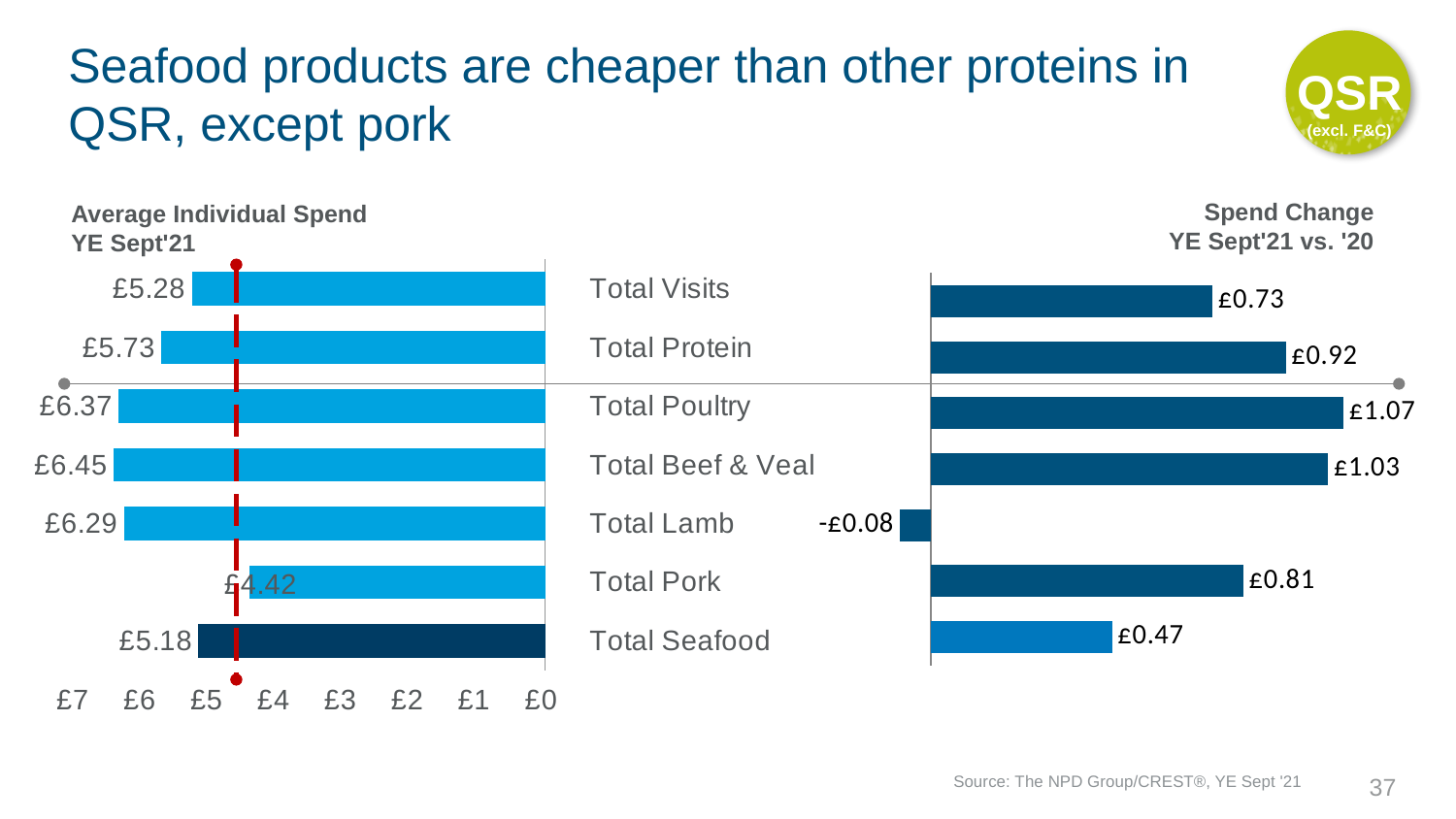
In the Spend Change chart, what is the value for Total Lamb? -£0.08 In the Spend Change chart, what is the value for Total Poultry? £1.07 How many categories are shown in the Average Individual Spend chart? 7 What kind of chart is the Spend Change chart? Bar chart In the Average Individual Spend chart, what is the difference between Total Beef & Veal and Total Seafood? £1.27 In the Average Individual Spend chart, what is the value for Total Pork? £4.42 In the Average Individual Spend chart, what is the value for Total Seafood? £5.18 In the Average Individual Spend chart, which category has the lowest value? Total Pork In the Average Individual Spend chart, which is larger, Total Poultry or Total Lamb? Total Poultry In the Spend Change chart, which category has the lowest value? Total Lamb In the Average Individual Spend chart, which category has the highest value? Total Beef & Veal In the Spend Change chart, what is the difference between Total Protein and Total Seafood? £0.45